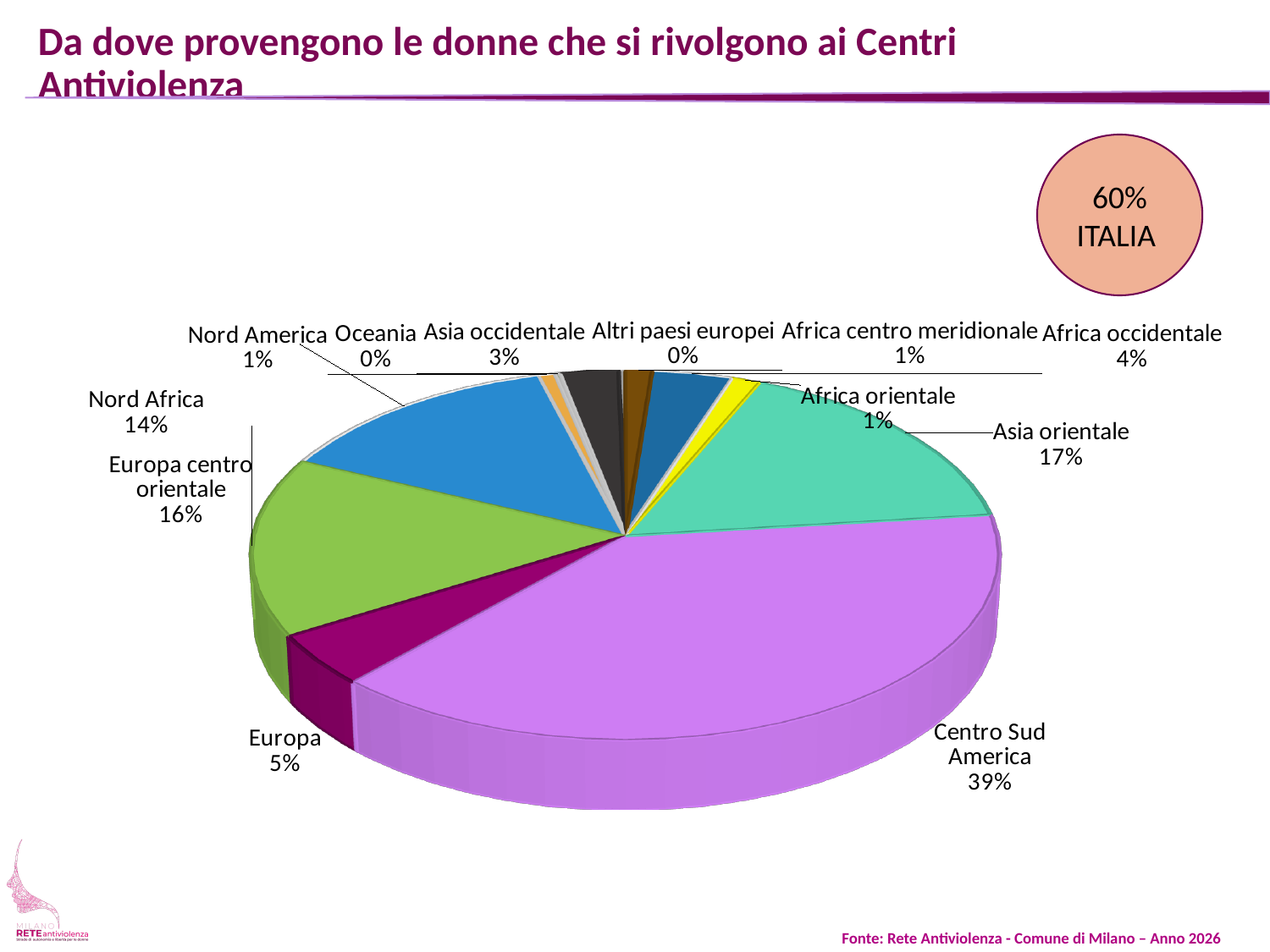
How many categories are shown in the pie chart? 12 What is the value shown for Nord Africa? 14% What percentage is shown for Europa centro orientale? 16% What is the value for Africa occidentale? 4% What percentage of the pie chart is Centro Sud America? 39% Which category has the largest slice of the pie chart? Centro Sud America What share does Asia orientale have in the pie chart? 17% Which is larger, Europa or Asia occidentale? Europa What percentage is shown in the circle labelled ITALIA at the top right of the slide? 60% What type of chart is shown on the slide? Pie chart Which is larger, Europa centro orientale or Nord Africa? Europa centro orientale What is the difference in percentage points between Centro Sud America and Asia orientale? 22